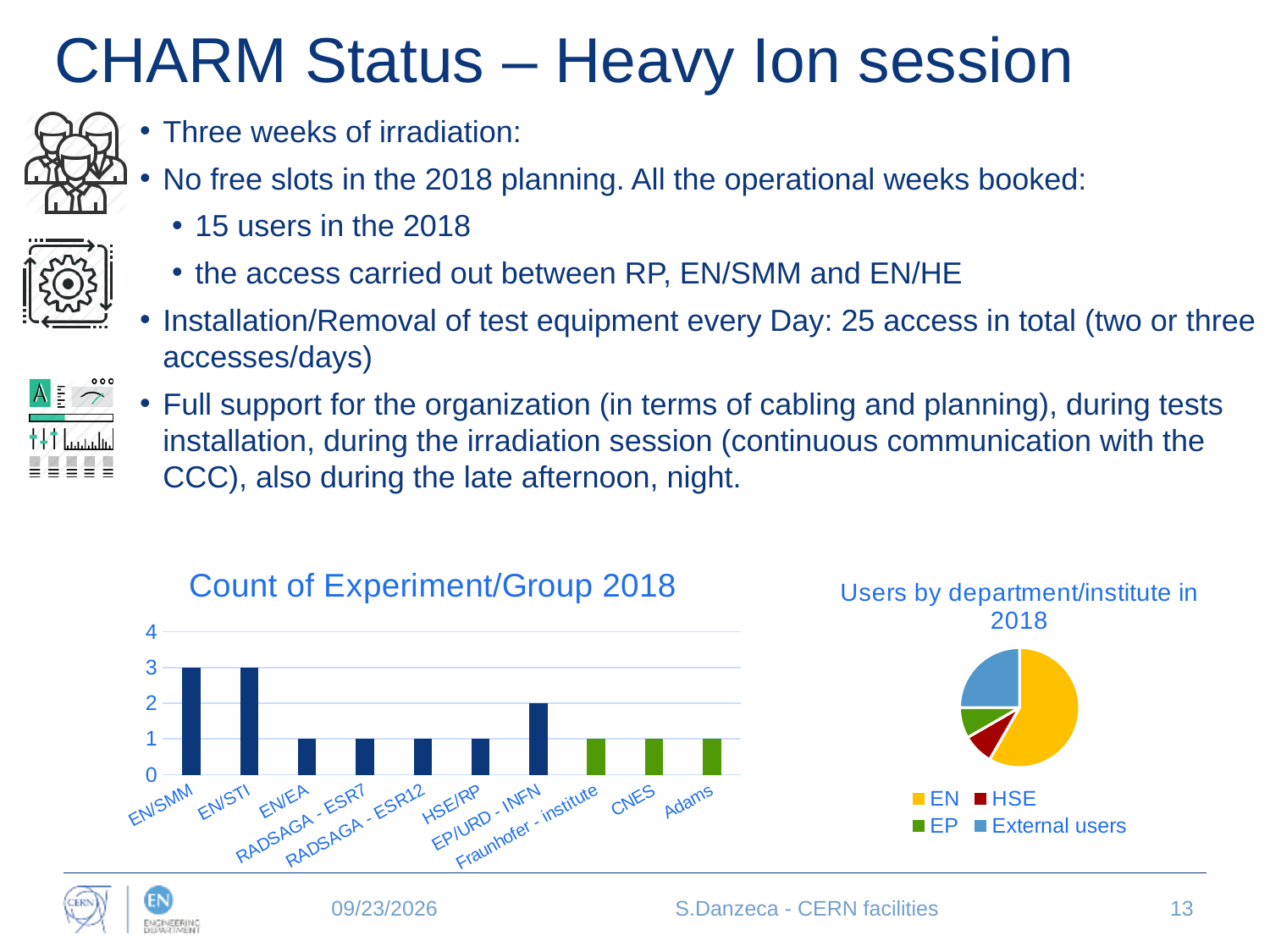
In the 'Count of Experiment/Group 2018' chart, which is larger, the value for EP/URD - INFN or the value for Adams? EP/URD - INFN In the 'Count of Experiment/Group 2018' chart, how many categories are shown on the x axis? 10 In the 'Users by department/institute in 2018' chart, which category has the largest slice? EN In the 'Count of Experiment/Group 2018' chart, is the value for EN/STI greater or less than 2? greater In the 'Count of Experiment/Group 2018' chart, what is the value for EN/SMM? 3 In the 'Count of Experiment/Group 2018' chart, what is the value for EP/URD - INFN? 2 In the 'Count of Experiment/Group 2018' chart, what is the value for CNES? 1 In the 'Count of Experiment/Group 2018' chart, what is the difference between the values for EN/STI and HSE/RP? 2 What kind of chart is 'Count of Experiment/Group 2018'? bar chart What kind of chart is 'Users by department/institute in 2018'? pie chart How many entries does the legend of the 'Users by department/institute in 2018' chart list? 4